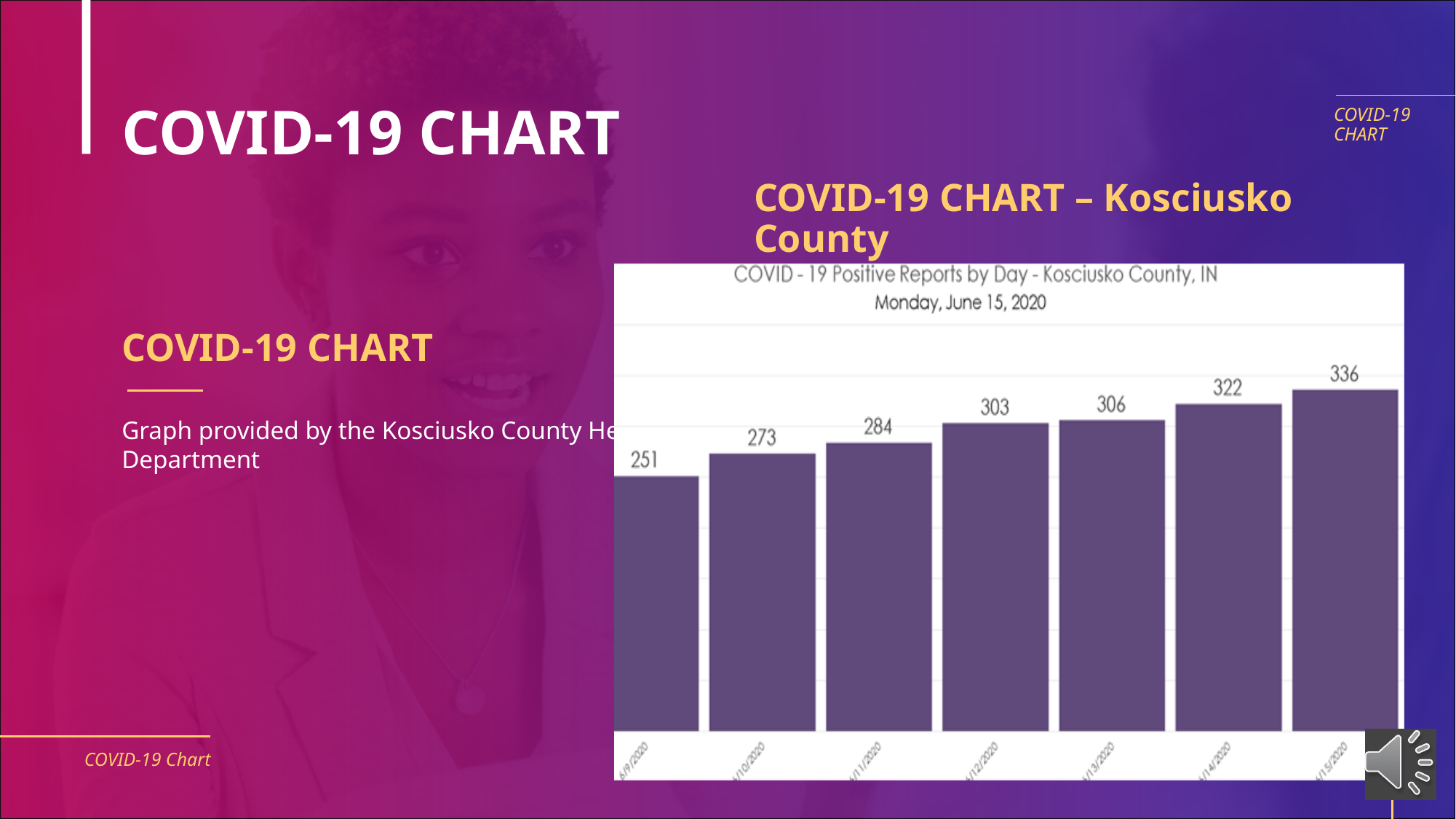
What date is shown in the subtitle of the chart? Monday, June 15, 2020 Which date has the highest value in the chart? 6/15/2020 What is the value of the bar labelled 6/12/2020? 303 What is the difference between the values for 6/15/2020 and 6/9/2020? 85 What kind of chart is shown on the slide? bar chart What is the value of the bar labelled 6/15/2020? 336 What is the value of the bar labelled 6/9/2020? 251 How many bars are plotted in the chart? 7 Which is larger, the value for 6/11/2020 or the value for 6/10/2020? 6/11/2020 Do the values rise or fall from left to right along the x axis? rise What is the difference between the values for 6/14/2020 and 6/13/2020? 16 Which date has the lowest value in the chart? 6/9/2020